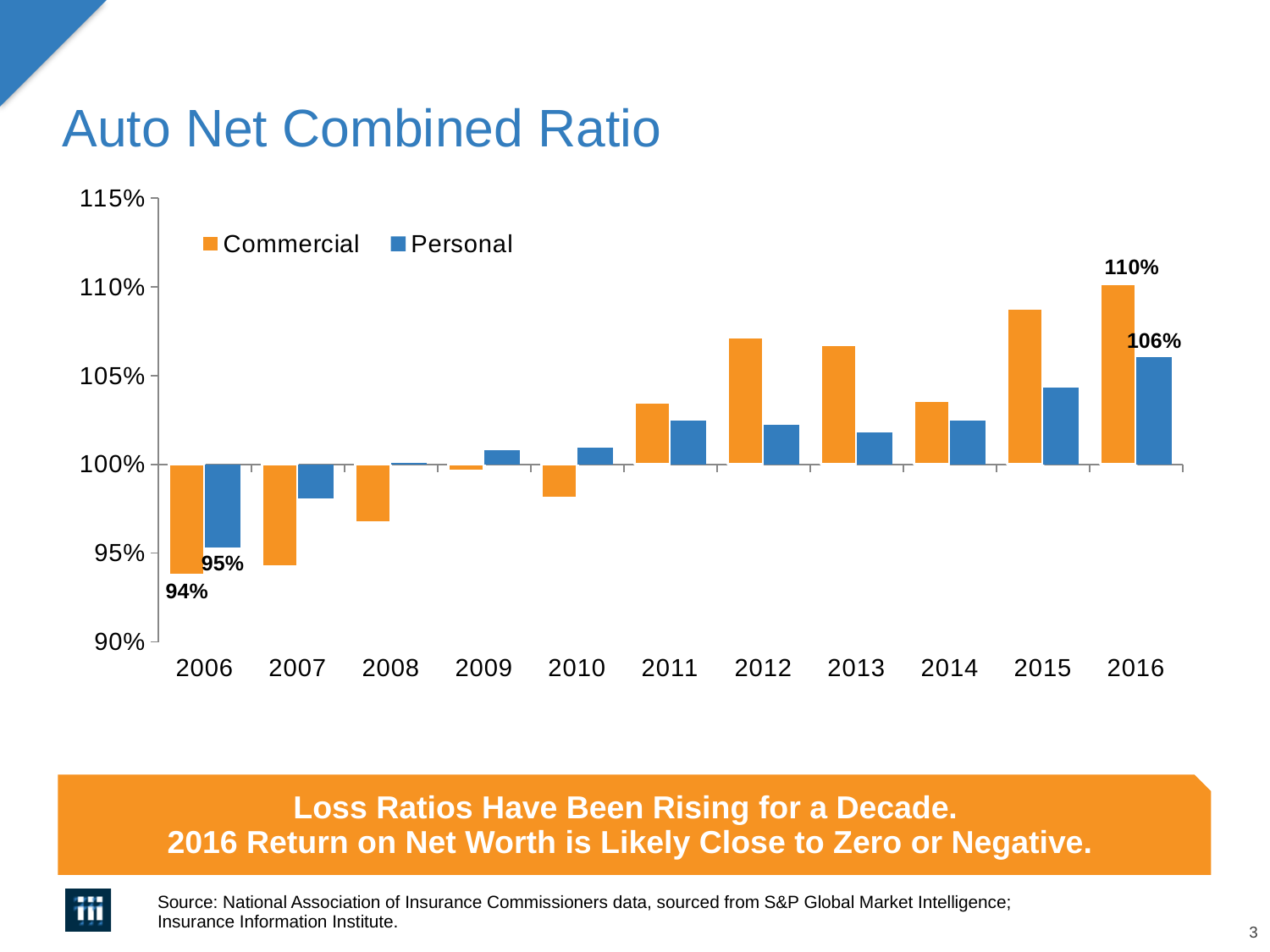
What is the Personal auto net combined ratio for 2016? 106% What is the Personal auto net combined ratio for 2006? 95% How many years are shown on the x axis? 11 What is the Commercial auto net combined ratio for 2006? 94% What kind of chart is shown on the slide? Bar chart By how many percentage points does the Commercial ratio exceed the Personal ratio in 2016? 4 percentage points Is the Commercial value for 2012 greater or less than 105%? greater Which colour represents the Commercial series in the legend? Orange How many series does the legend list? 2 What is the Commercial auto net combined ratio for 2016? 110% Is the Personal value for 2007 greater or less than 100%? less In which year is the Commercial combined ratio highest? 2016